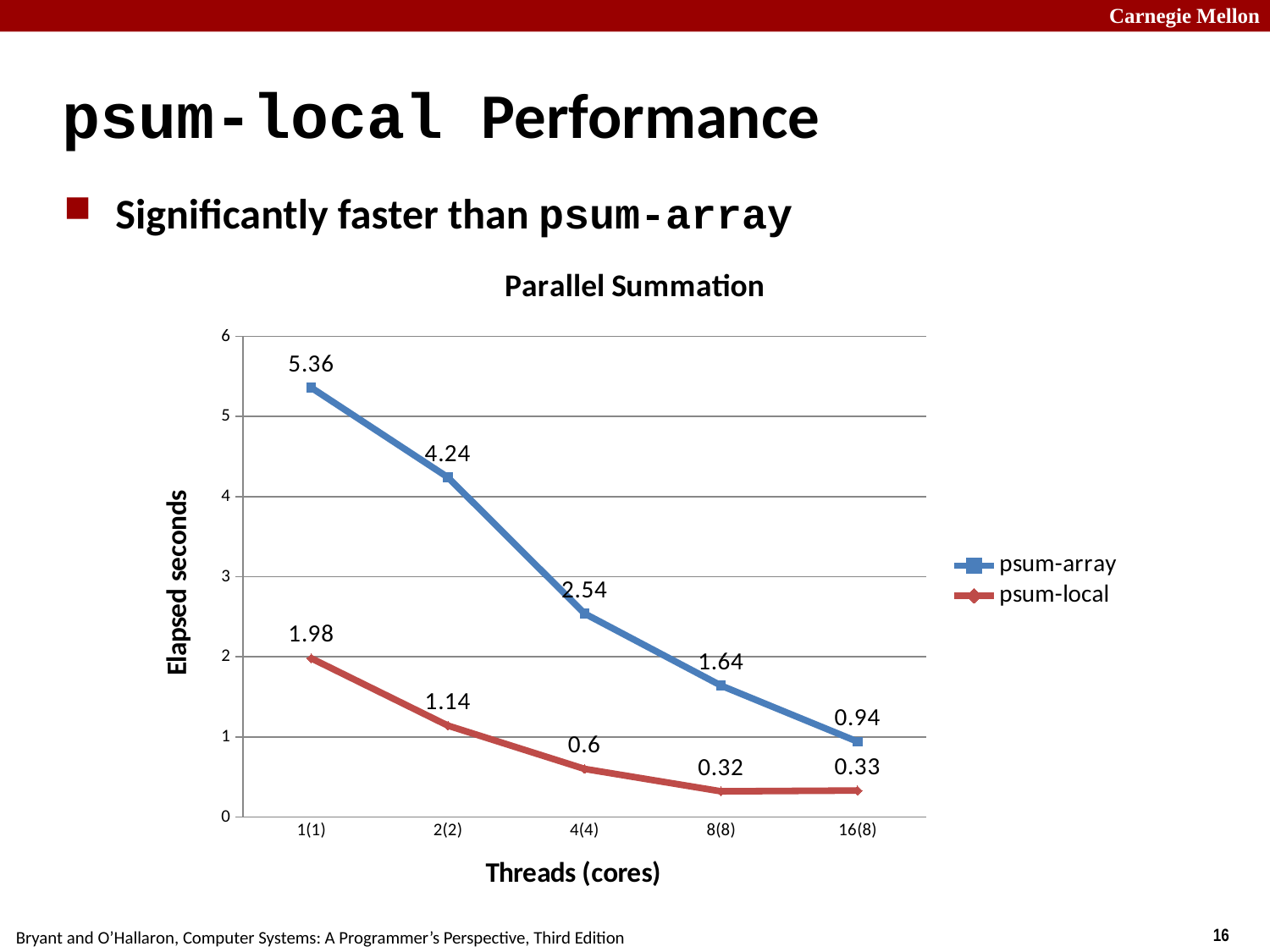
What is the elapsed seconds value for psum-local at 4(4) threads (cores)? 0.6 What kind of chart is shown on the slide? line chart What is the difference between the psum-array and psum-local values at 2(2) threads (cores)? 3.1 Which series has the larger value at 8(8) threads (cores), psum-array or psum-local? psum-array At which threads (cores) setting is the psum-array value highest? 1(1) How many threads (cores) settings are plotted on the x axis? 5 What is the title of the chart? Parallel Summation How many series does the legend list? 2 Do the psum-array values rise or fall as the number of threads (cores) increases? fall What is the elapsed seconds value for psum-array at 1(1) threads (cores)? 5.36 At which threads (cores) setting is the psum-local value lowest? 8(8) What is the elapsed seconds value for psum-array at 16(8) threads (cores)? 0.94